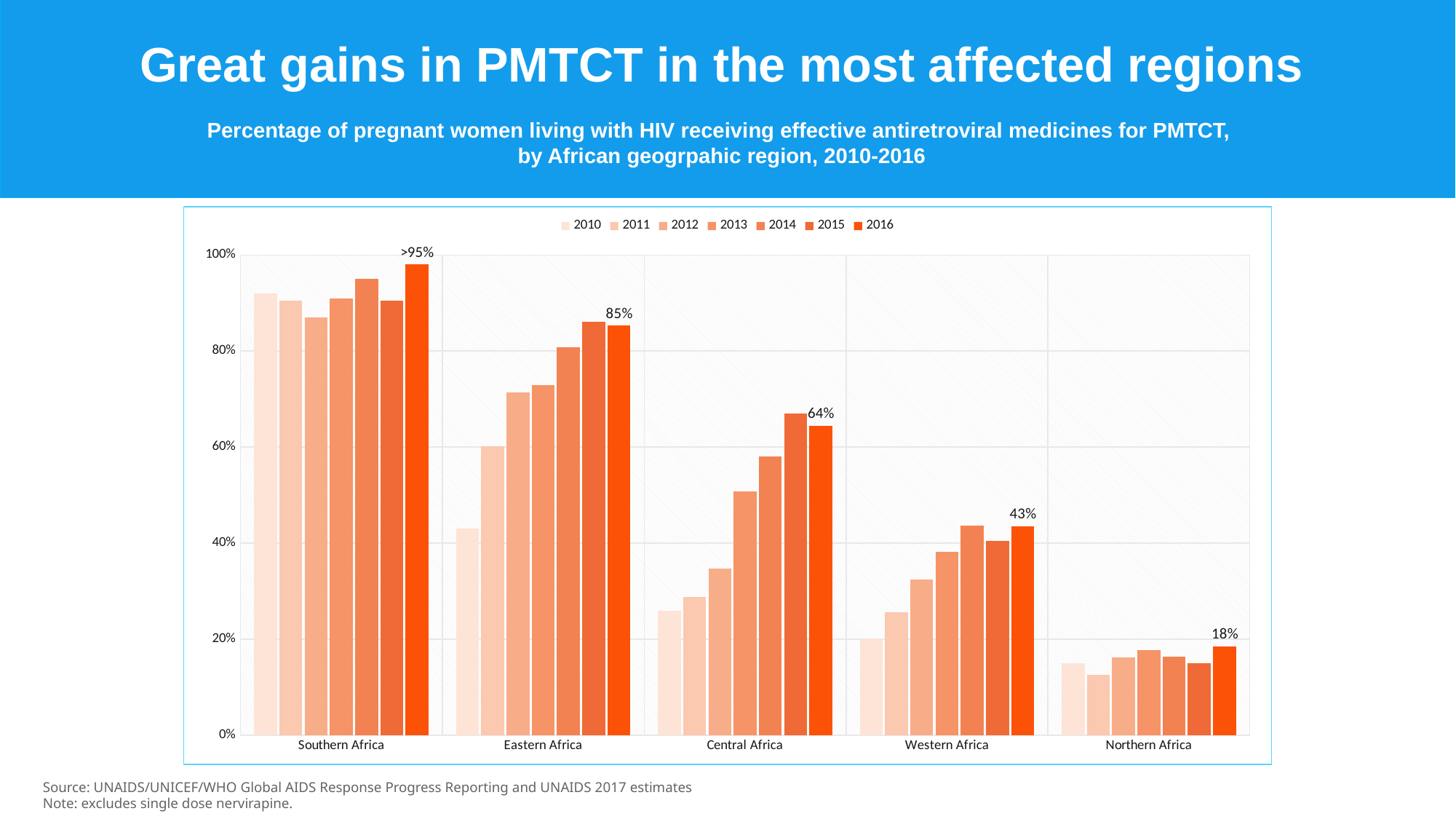
Do the values for Central Africa rise or fall from 2010 to 2016? rise What is the 2016 value for Central Africa? 64% What is the difference between the 2016 values for Eastern Africa and Central Africa? 21 percentage points Which region has the lowest value in 2016? Northern Africa Which is larger in 2016: Central Africa or Western Africa? Central Africa Is the 2010 value for Central Africa greater or less than 40%? less Which region has the highest value in 2016? Southern Africa What is the 2016 value for Northern Africa? 18% What data label is shown for Southern Africa in 2016? >95% How many regions are shown on the x axis? 5 How many years does the legend list? 7 What is the 2016 value for Eastern Africa? 85%